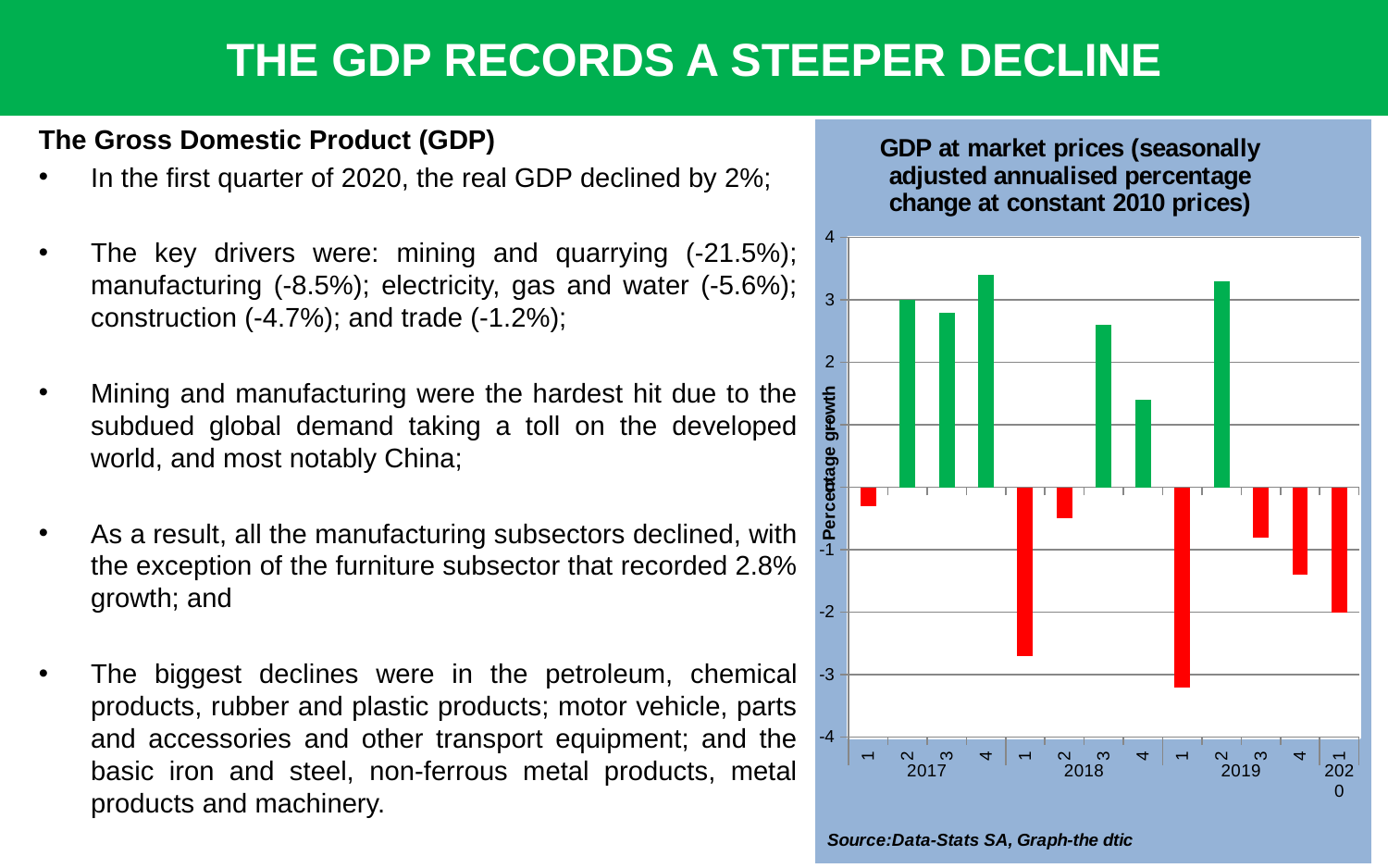
Which is larger, the value for Q2 2017 or the value for Q4 2018? Q2 2017 Is the value for Q2 2017 greater or less than 2? greater What is the label on the vertical axis of the chart? Percentage growth What colour are the bars with negative values in the chart? red How many quarterly bars are plotted in the GDP chart? 13 What kind of chart is shown on the slide? bar chart What is the value for Q1 2020 in the GDP chart? -2 Which quarter has the lowest value in the GDP chart? Q1 2019 How many bars in the GDP chart show negative growth? 7 Is the value for Q1 2018 greater or less than -2? less Is the value for Q4 2018 greater or less than 1? greater